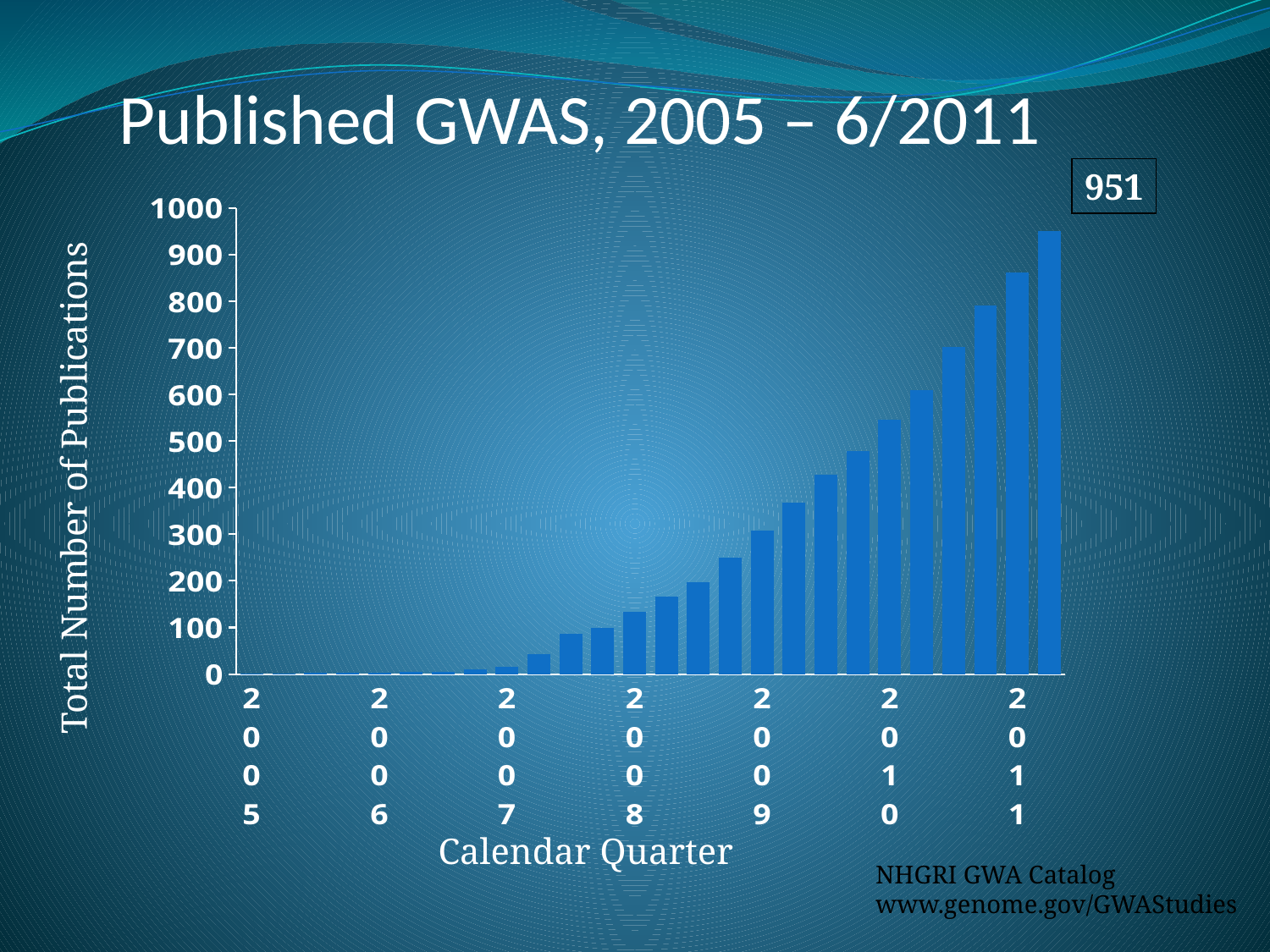
Is the value of the bar directly above the 2010 label greater or less than 500? greater Do the bar values rise or fall from left to right along the x axis? rise Which year's bars are the tallest on the chart? 2011 Is the value of the tallest (rightmost) bar greater or less than 900? greater What is the highest value shown on the vertical axis? 1000 Is the value of the bar directly above the 2009 label greater or less than 400? less What is the label of the vertical axis? Total Number of Publications What value is printed in the box above the tallest bar at the right of the chart? 951 What kind of chart is shown on the slide? bar chart What is the title of the chart? Published GWAS, 2005 – 6/2011 Which is larger: the bar above the 2011 label or the bar above the 2008 label? 2011